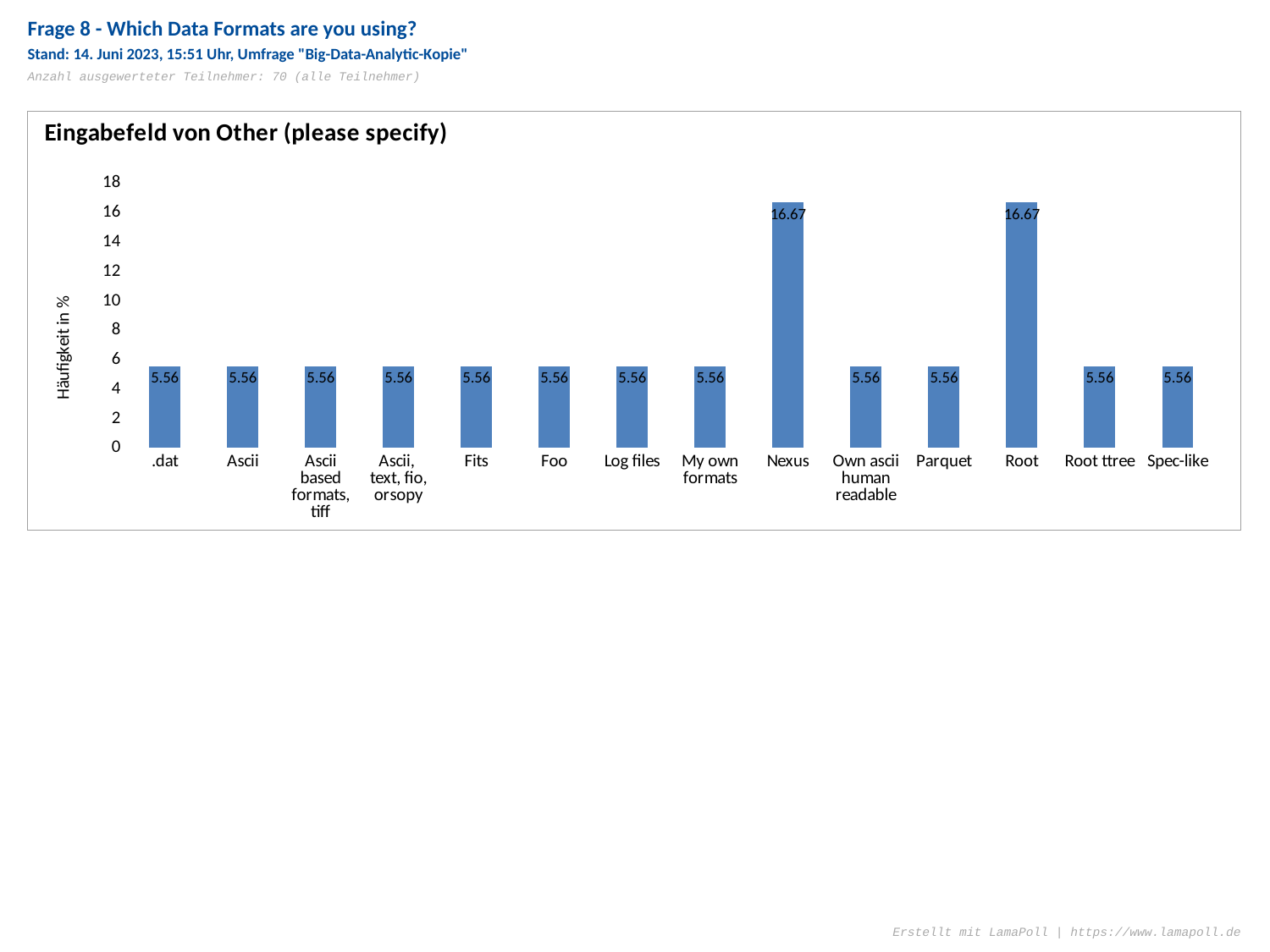
What is the value for Parquet? 5.56 What is the difference between the value for Nexus and the value for Fits? 11.11 How many categories are shown on the x axis? 14 What is the value for Nexus? 16.67 What is the title of the chart? Eingabefeld von Other (please specify) What is the value for Root? 16.67 Is the value for Foo greater or less than 10? less Which is larger, the value for Root or the value for Spec-like? Root What kind of chart is shown on the slide? bar chart What is the value for Log files? 5.56 What is the label of the y axis? Häufigkeit in % Which two categories have the highest value? Nexus and Root